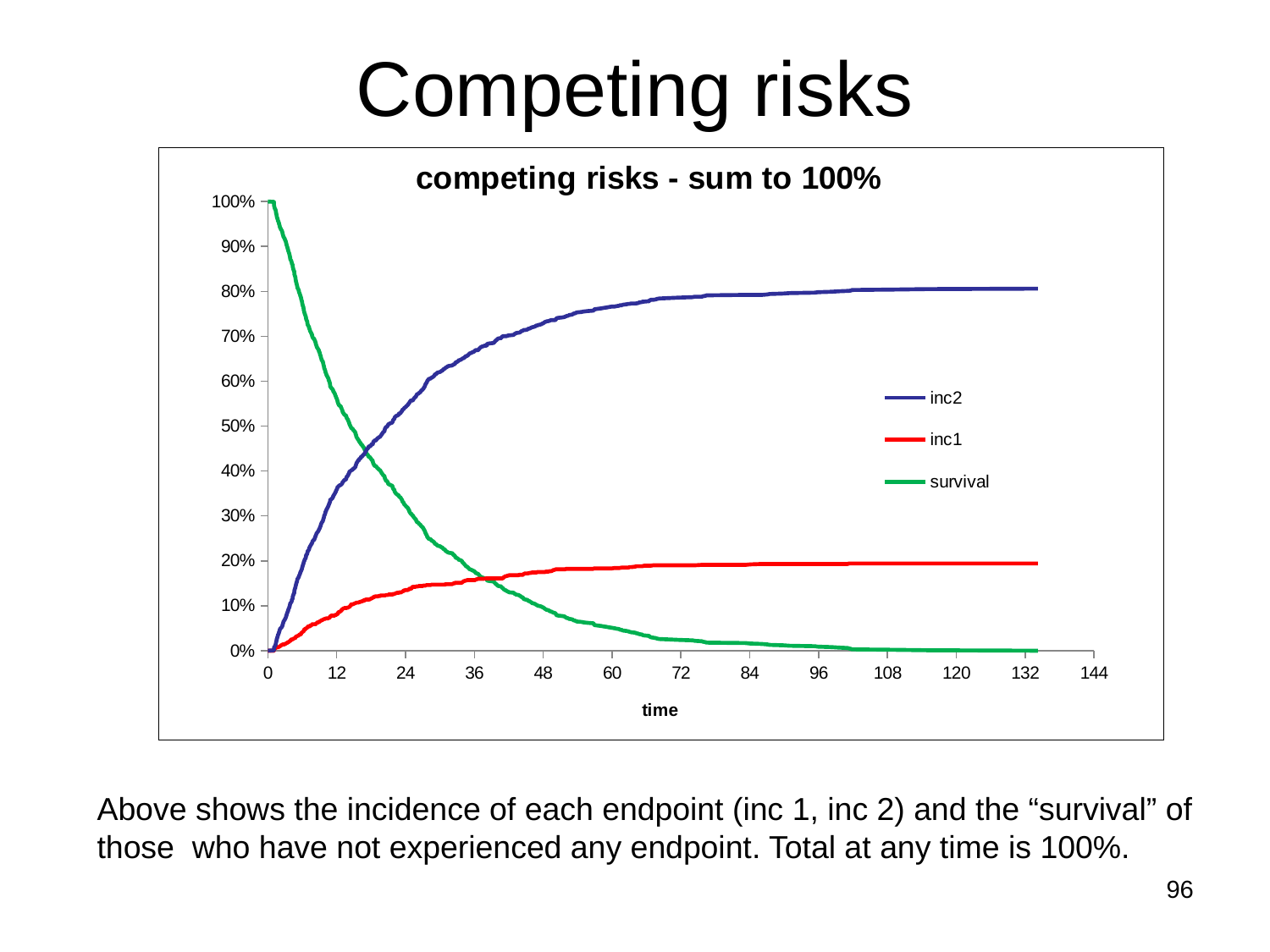
Is the value of inc1 at time 132 greater or less than 30%? less What is the label of the x axis? time What is the title of the chart? competing risks - sum to 100% Is the value of inc2 at time 132 greater or less than 70%? greater How many series does the legend list? 3 Which series has the highest value at time 132? inc2 What is the value of the survival series at time 0? 100% What kind of chart is shown on the slide? line chart Is the value of survival at time 72 greater or less than 10%? less At time 12, which is larger: survival or inc2? survival Does the survival series rise or fall as time increases? fall Does the inc2 series rise or fall as time increases? rise